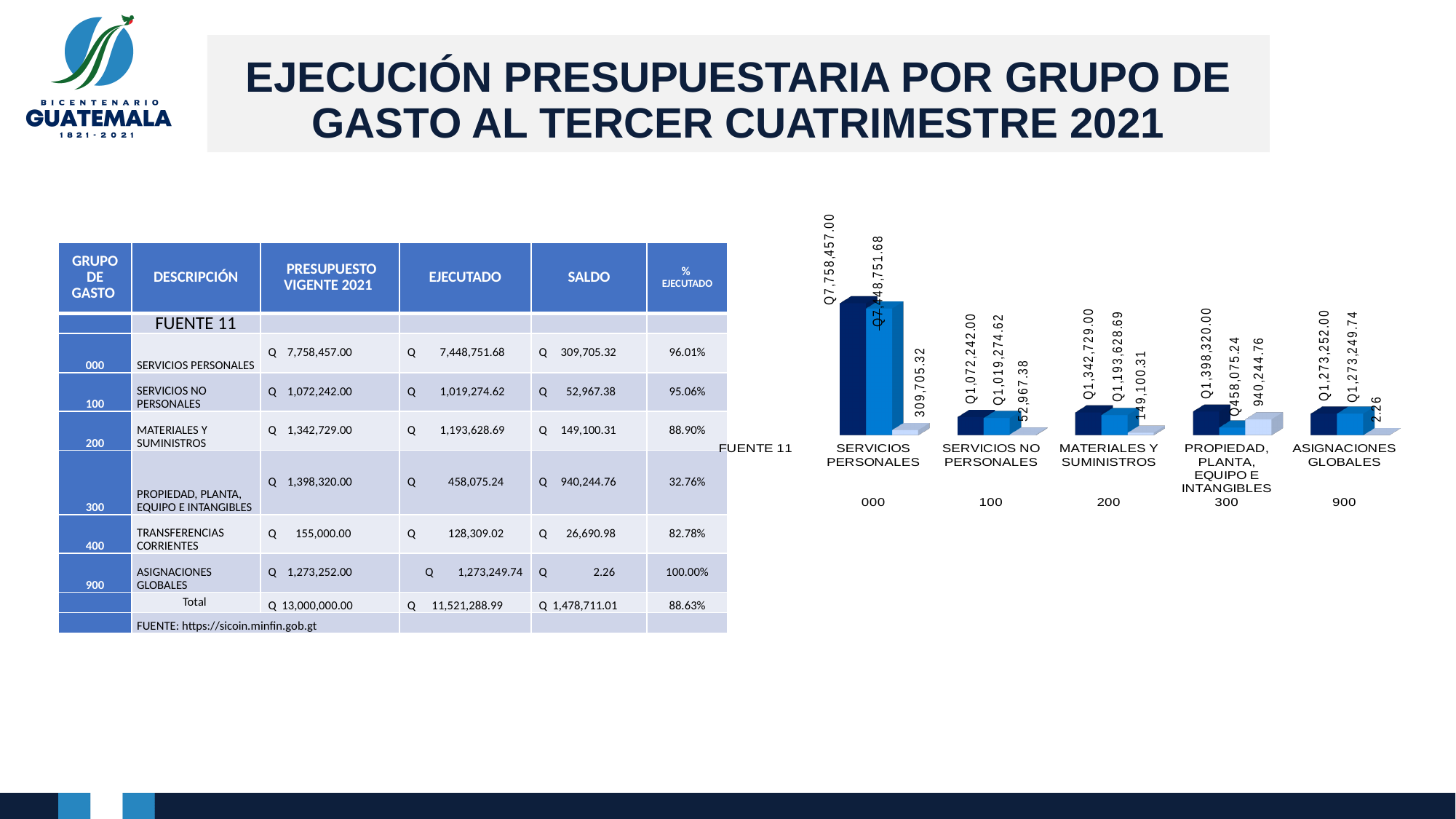
What is the value of the light blue (third) bar for PROPIEDAD, PLANTA, EQUIPO E INTANGIBLES in the chart? 940,244.76 What is the value of the light blue (third) bar for ASIGNACIONES GLOBALES in the chart? 2.26 What is the value of the dark blue (first) bar for SERVICIOS PERSONALES in the chart? Q7,758,457.00 What is the value of the medium blue (second) bar for MATERIALES Y SUMINISTROS in the chart? Q1,193,628.69 What kind of chart is shown on the slide? bar chart Which category has the highest dark blue (first) bar in the chart? SERVICIOS PERSONALES In the chart, which is larger: the medium blue (second) bar for SERVICIOS NO PERSONALES or the medium blue bar for PROPIEDAD, PLANTA, EQUIPO E INTANGIBLES? SERVICIOS NO PERSONALES What label appears at the left of the chart's category axis? FUENTE 11 What is the difference between the dark blue (first) bar and the medium blue (second) bar for SERVICIOS NO PERSONALES in the chart? 52,967.38 How many categories are plotted along the x axis of the chart? 5 What is the difference between the dark blue (first) bar and the medium blue (second) bar for PROPIEDAD, PLANTA, EQUIPO E INTANGIBLES in the chart? 940,244.76 Which category has the lowest light blue (third) bar in the chart? ASIGNACIONES GLOBALES